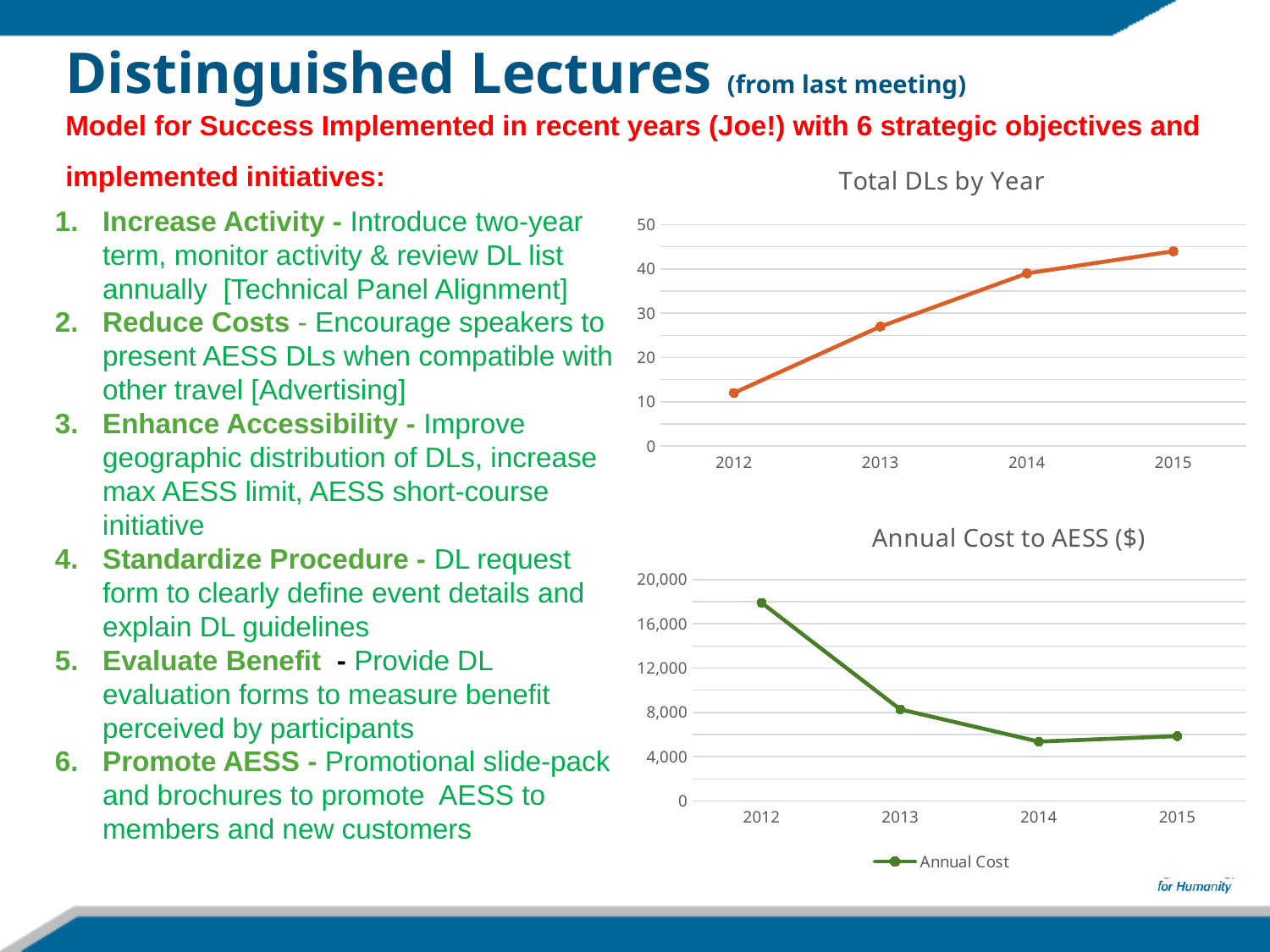
In the 'Total DLs by Year' chart, is the value for 2015 greater or less than 50? less In the 'Total DLs by Year' chart, do the values rise or fall from 2012 to 2015? rise In the 'Total DLs by Year' chart, which year has the highest value? 2015 In the 'Annual Cost to AESS ($)' chart, how many series does the legend list? 1 In the 'Total DLs by Year' chart, how many years are plotted on the x axis? 4 In the 'Total DLs by Year' chart, which year has the lowest value? 2012 In the 'Annual Cost to AESS ($)' chart, which is larger, the value for 2012 or the value for 2013? 2012 In the 'Annual Cost to AESS ($)' chart, which year has the highest annual cost? 2012 In the 'Annual Cost to AESS ($)' chart, is the value for 2013 greater or less than 12,000? less In the 'Total DLs by Year' chart, is the value for 2013 greater or less than 20? greater In the 'Total DLs by Year' chart, what kind of chart is shown? line chart In the 'Annual Cost to AESS ($)' chart, which year has the lowest annual cost? 2014